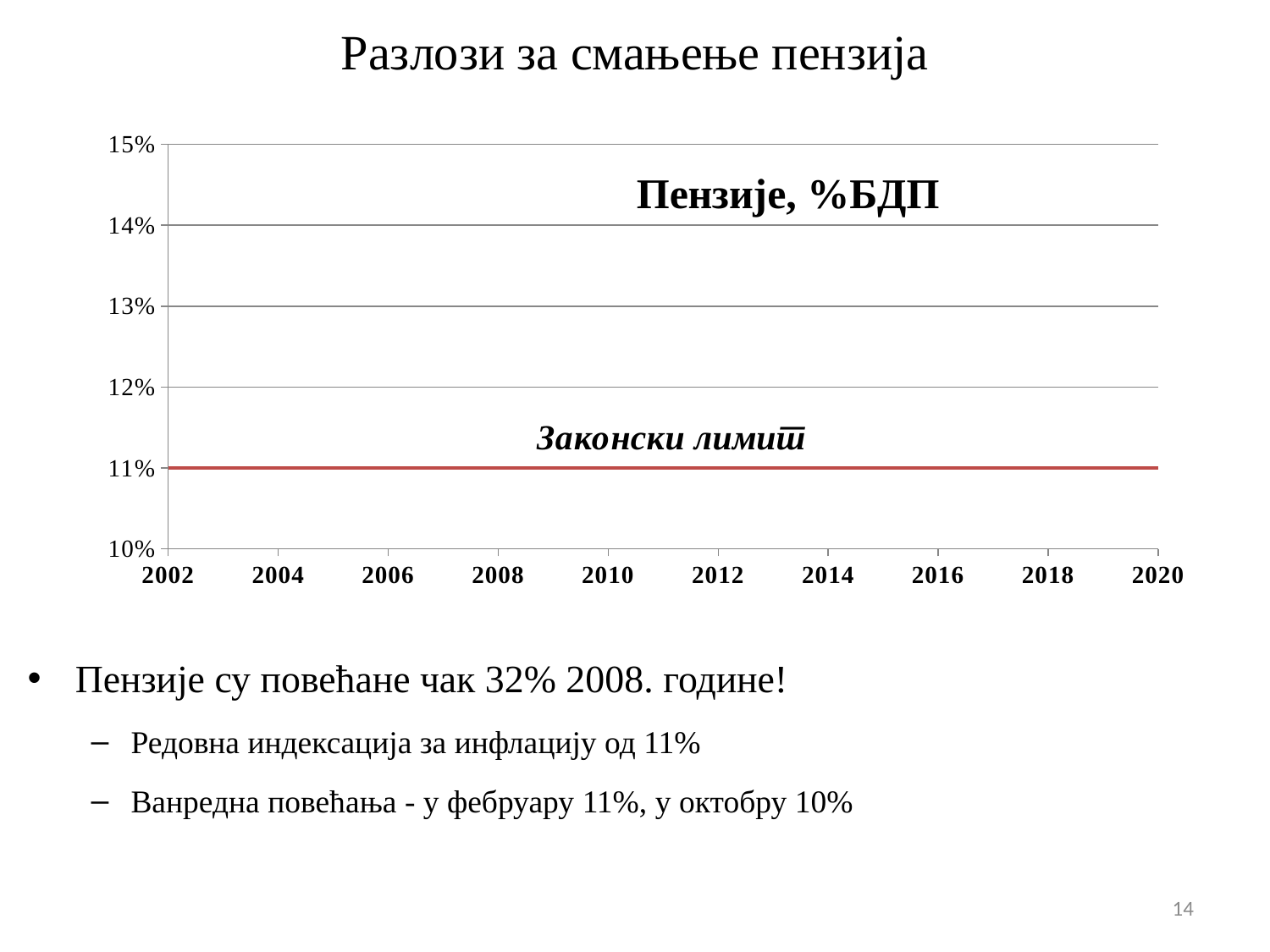
What is the label of the red horizontal line in the chart? Законски лимит At what value does the red line labelled 'Законски лимит' sit on the y axis? 11% Is the value of the 'Законски лимит' line greater or less than 12%? less What kind of chart is shown on the slide? line chart How many year labels are shown on the x axis? 10 What is the title of the chart? Пензије, %БДП Is the value of the 'Законски лимит' line greater or less than 10%? greater What is the last year shown on the x axis? 2020 What is the lowest value shown on the y axis? 10% Does the 'Законски лимит' line rise, fall or stay flat from 2002 to 2020? stays flat What is the first year shown on the x axis? 2002 What is the highest value shown on the y axis? 15%